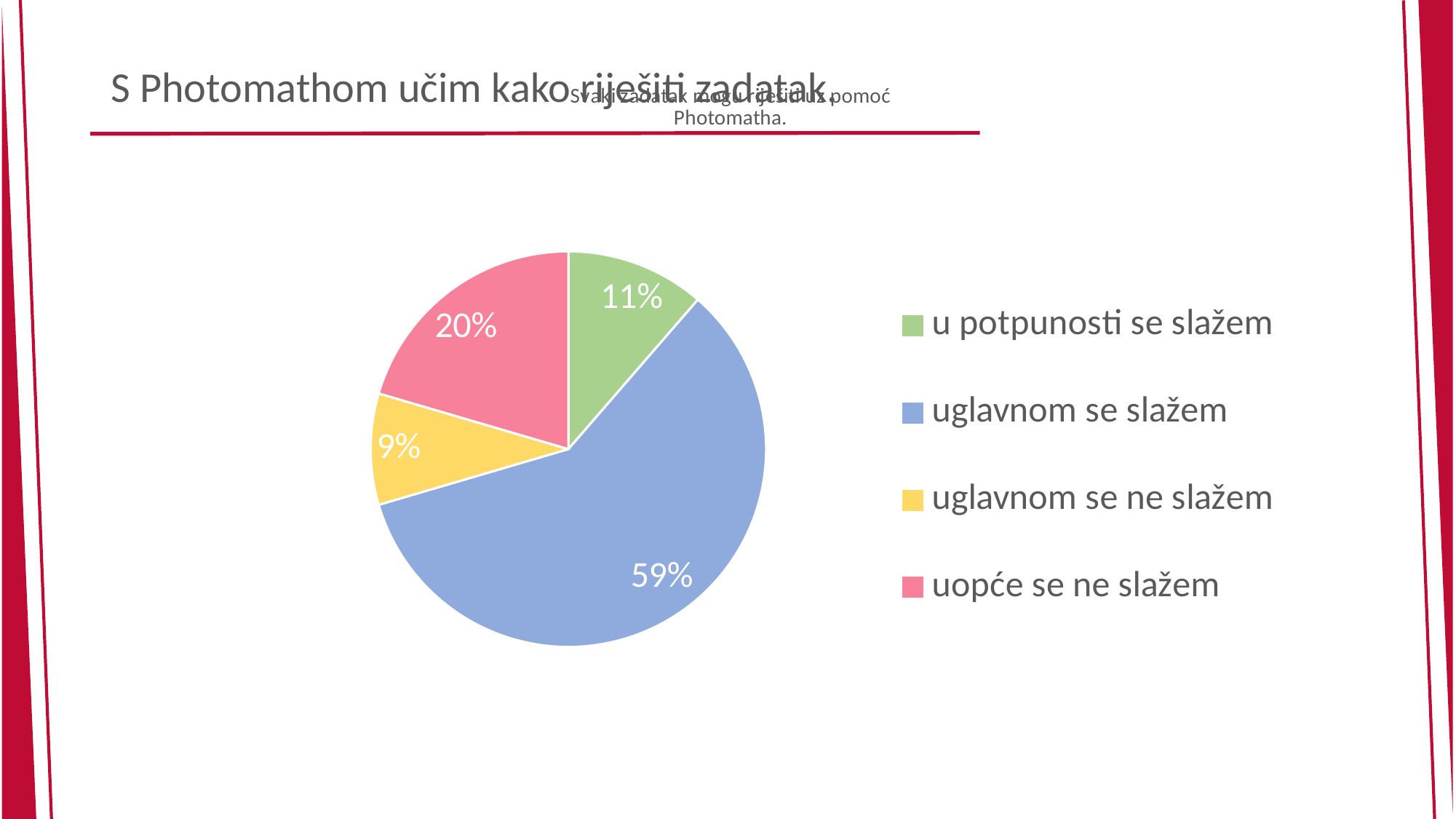
Which category has the smallest slice of the pie? uglavnom se ne slažem What share of the pie does "u potpunosti se slažem" have? 11% What colour is the slice for "uglavnom se ne slažem"? yellow What share of the pie does "uopće se ne slažem" have? 20% What share of the pie does "uglavnom se slažem" have? 59% What kind of chart is shown on the slide? pie chart How many entries does the legend list? 4 What is the difference in percentage points between "uglavnom se slažem" and "uopće se ne slažem"? 39 Which is larger, the slice for "uopće se ne slažem" or the slice for "u potpunosti se slažem"? uopće se ne slažem How many slices does the pie chart have? 4 Which category has the largest slice of the pie? uglavnom se slažem